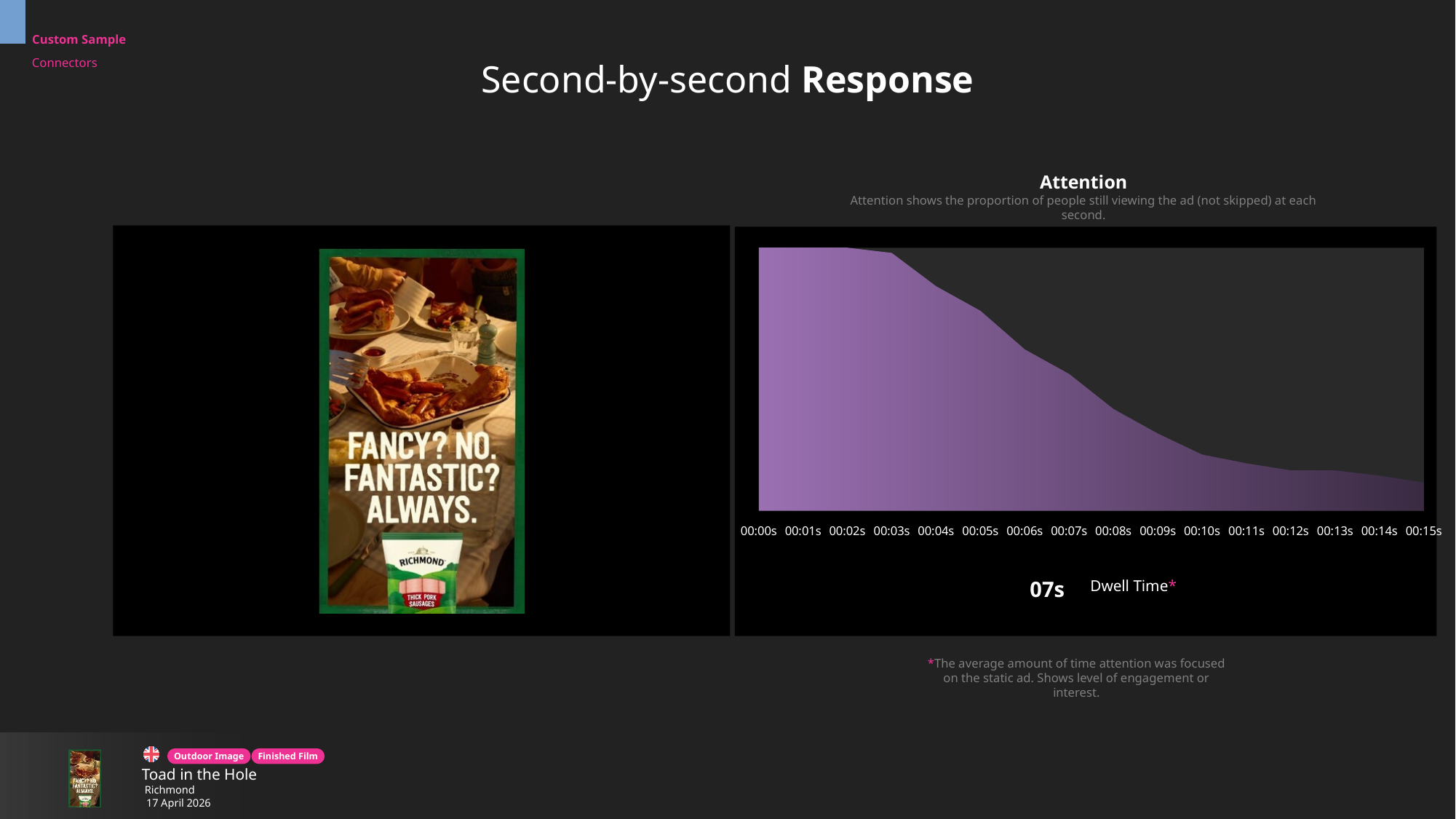
How many time points are labelled on the x axis of the Attention chart? 16 At which time point is the Attention chart at its lowest? 00:15s In the Attention chart, is the value at 00:03s or at 00:10s larger? 00:03s What is the last time label on the x axis of the Attention chart? 00:15s What is the Dwell Time shown below the Attention chart? 07s In the Attention chart, do the values rise or fall as time moves from 00:00s to 00:15s? fall In the Attention chart, is the value at 00:12s or at 00:06s larger? 00:06s What is the first time label on the x axis of the Attention chart? 00:00s What colour is the shaded area in the Attention chart? purple What kind of chart is shown under the 'Attention' heading? area chart What is the title of the chart on the right of the slide? Attention